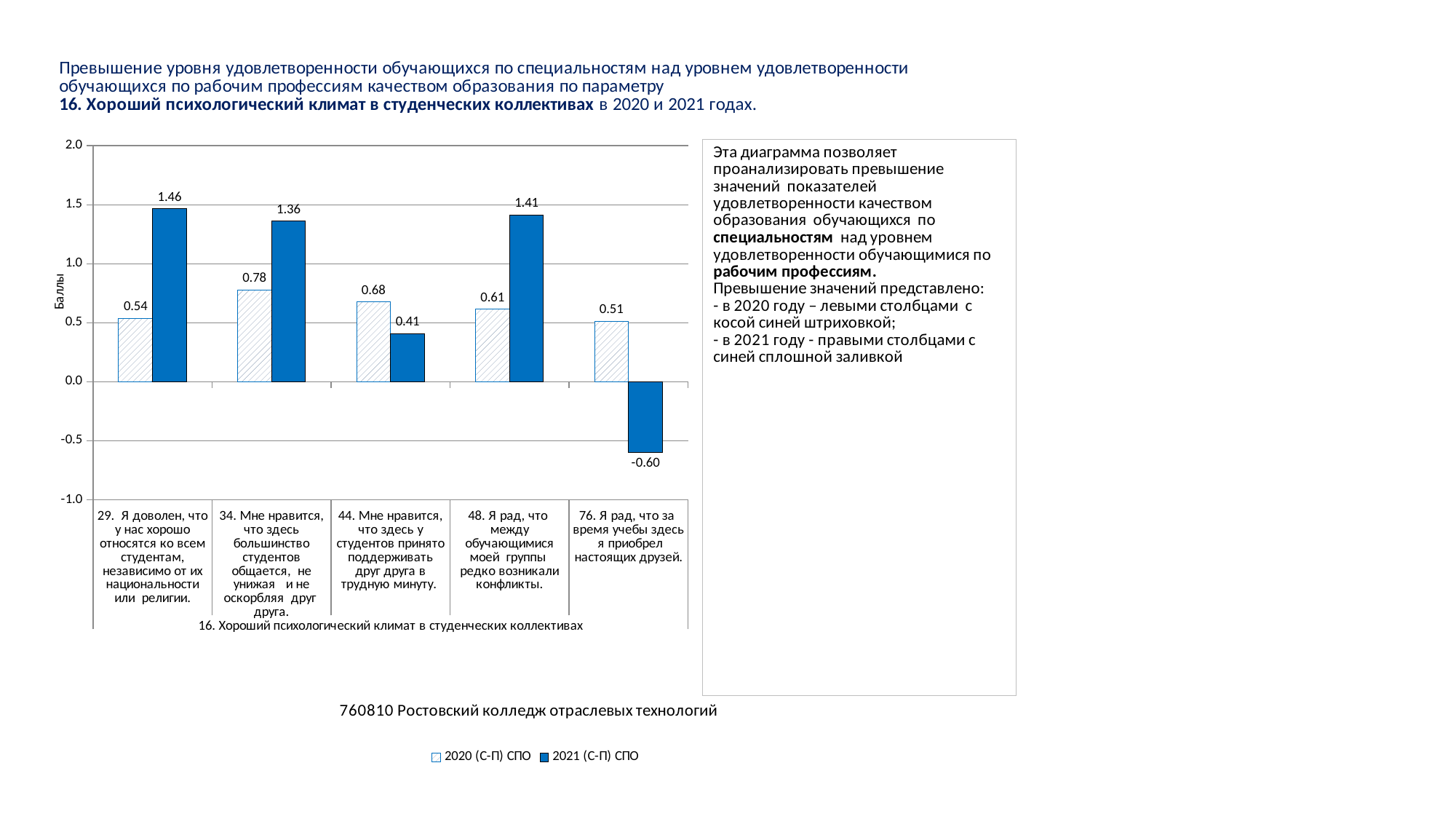
What is the value for 2021 (С-П) СПО for item 76 (Я рад, что за время учебы здесь я приобрел настоящих друзей)? -0.60 How many series does the legend list? 2 What is the value for 2021 (С-П) СПО for item 44 (Мне нравится, что здесь у студентов принято поддерживать друг друга в трудную минуту)? 0.41 What is the label of the vertical axis of the chart? Баллы What is the difference between the 2021 and 2020 values for item 34 (Мне нравится, что здесь большинство студентов общается, не унижая и не оскорбляя друг друга)? 0.58 What kind of chart is shown on the slide? bar chart How many items (categories) are shown on the x axis of the chart? 5 Which item has the lowest value for 2020 (С-П) СПО? 76. Я рад, что за время учебы здесь я приобрел настоящих друзей. Is the value for 2021 (С-П) СПО for item 48 greater or less than 1.0? greater What is the value for 2020 (С-П) СПО for item 29 (Я доволен, что у нас хорошо относятся ко всем студентам...)? 0.54 For item 44, which series has the larger value: 2020 (С-П) СПО or 2021 (С-П) СПО? 2020 (С-П) СПО Which item has the highest value for 2021 (С-П) СПО? 29. Я доволен, что у нас хорошо относятся ко всем студентам, независимо от их национальности или религии.